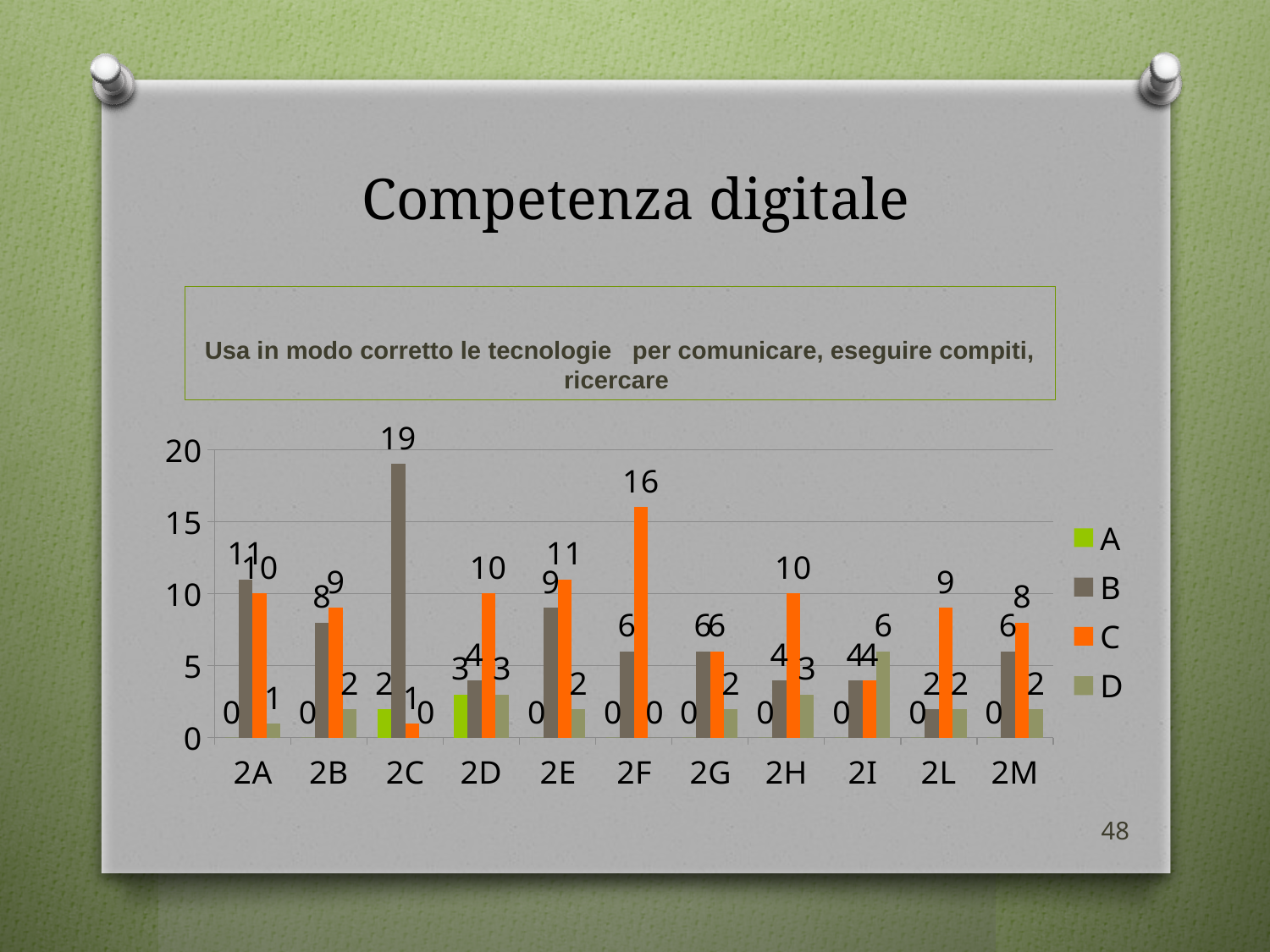
What is the value of series C for category 2F? 16 What is the value of series D for category 2I? 6 What kind of chart is shown on the slide? bar chart Which category has the highest value for series C? 2F Which category has the highest value for series B? 2C What is the title of the slide? Competenza digitale How many series does the legend list? 4 What is the value of series B for category 2C? 19 Is the value of series B for category 2C greater or less than 15? greater What is the difference between series B and series C for category 2C? 18 For category 2A, which is larger: series B or series C? B How many categories are shown on the x axis? 11